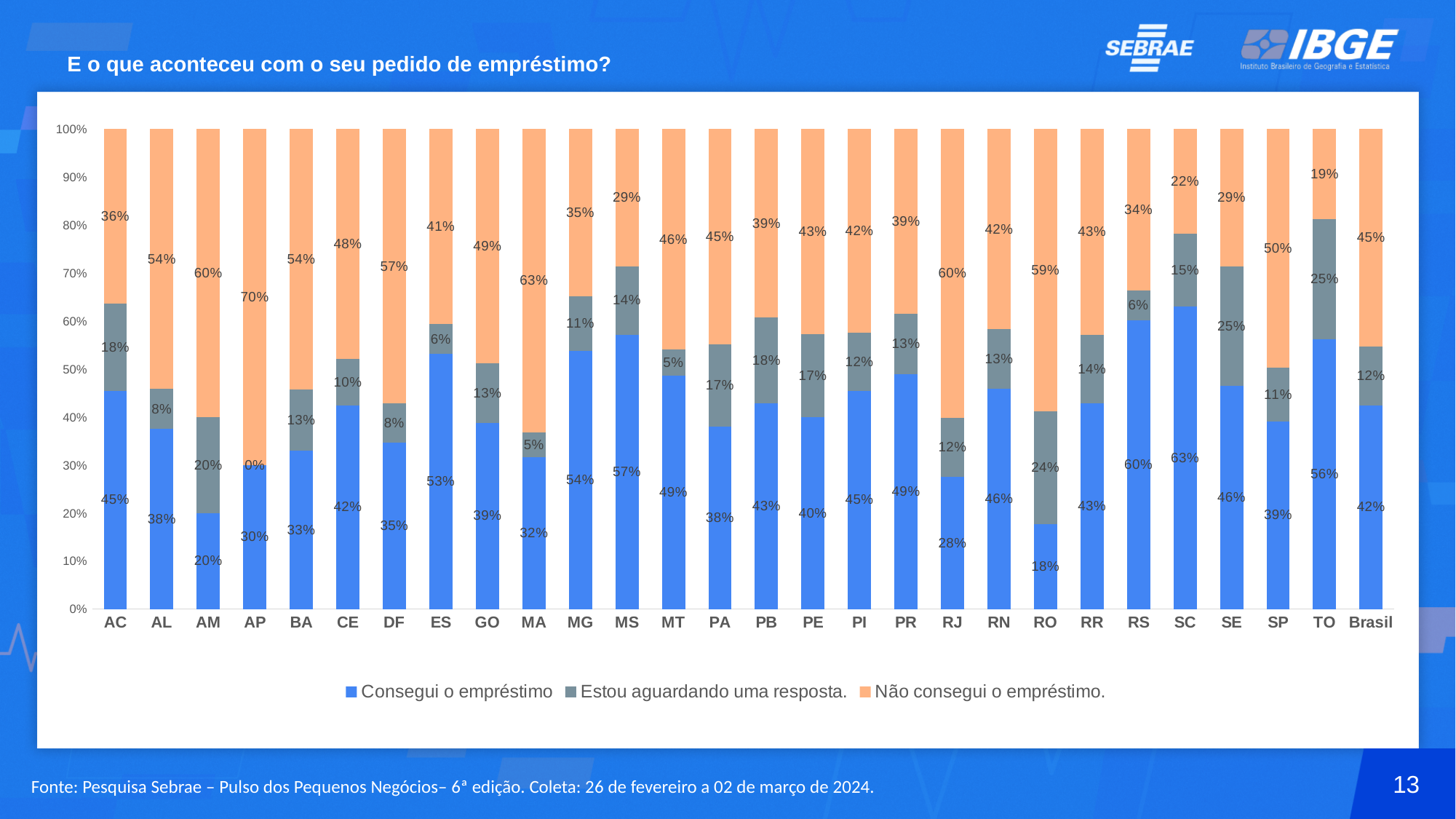
Which has a larger "Não consegui o empréstimo" value, MA or MG? MA What is the value for "Estou aguardando uma resposta." for Brasil? 12% What percentage of respondents in SC answered "Consegui o empréstimo"? 63% What is the value for "Não consegui o empréstimo" in AP? 70% How many series does the legend list? 3 What is the difference between the "Consegui o empréstimo" values for RS and RJ? 32% Which category has the lowest value for "Consegui o empréstimo"? RO Which category has the lowest value for "Não consegui o empréstimo"? TO How many categories are shown on the x axis? 28 Which category has the highest value for "Consegui o empréstimo"? SC What kind of chart is shown on the slide? Stacked bar chart Which series is shown in orange in the legend? Não consegui o empréstimo.